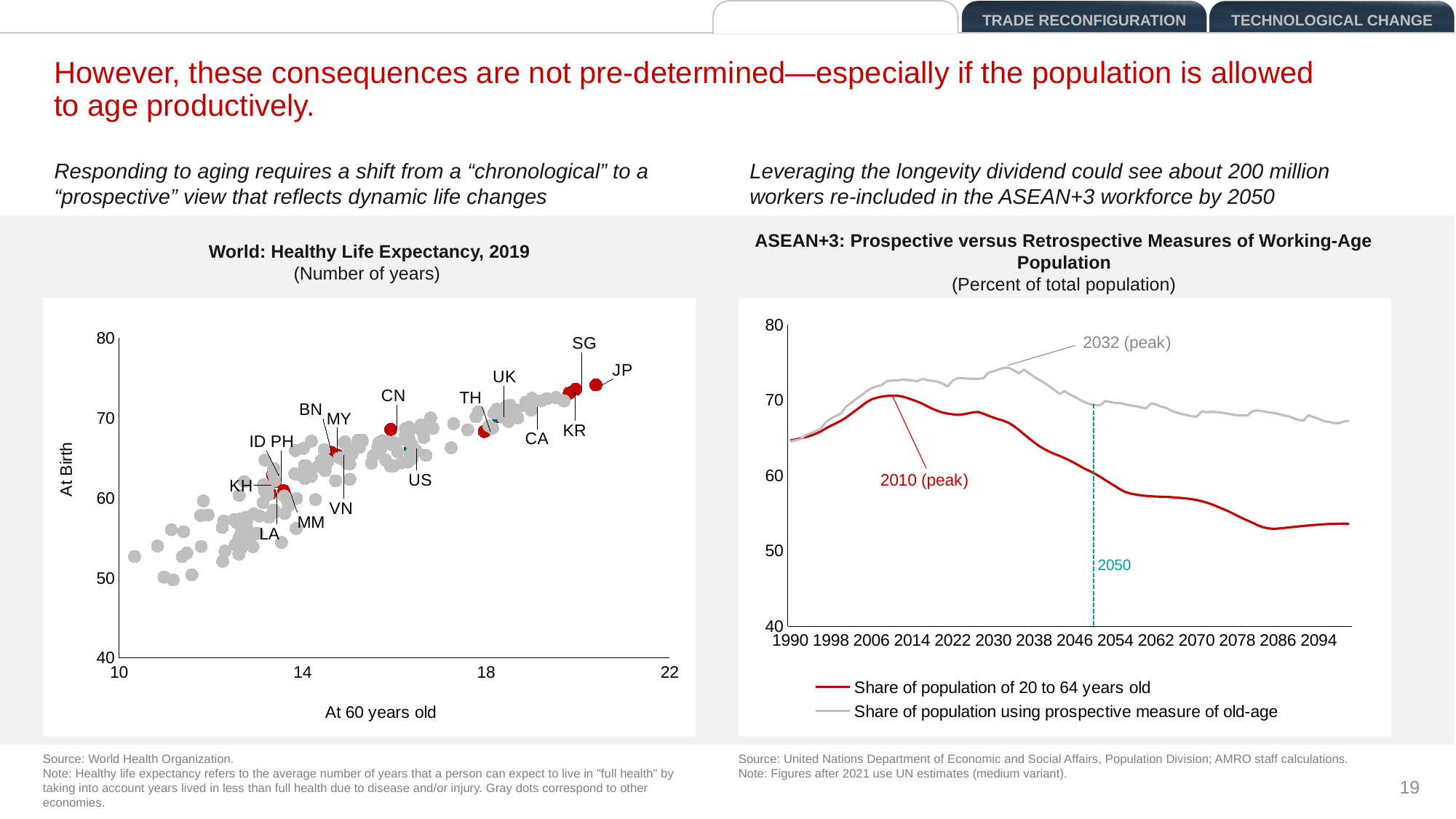
In the right chart 'ASEAN+3: Prospective versus Retrospective Measures of Working-Age Population', in which year does the share of population using the prospective measure of old-age peak? 2032 How many series does the legend of the right chart 'ASEAN+3: Prospective versus Retrospective Measures of Working-Age Population' list? 2 In the right chart 'ASEAN+3: Prospective versus Retrospective Measures of Working-Age Population', is the share of population of 20 to 64 years old in 2094 greater or less than 60? less In the left chart 'World: Healthy Life Expectancy, 2019', what is the label of the x axis? At 60 years old In the right chart 'ASEAN+3: Prospective versus Retrospective Measures of Working-Age Population', in which year does the share of population of 20 to 64 years old peak? 2010 In the left chart 'World: Healthy Life Expectancy, 2019', which has a higher healthy life expectancy at birth, SG or KH? SG In the left chart 'World: Healthy Life Expectancy, 2019', is the healthy life expectancy at 60 years old for KH greater or less than 14? less In the left chart 'World: Healthy Life Expectancy, 2019', which labeled economy has the highest healthy life expectancy at birth? JP In the left chart 'World: Healthy Life Expectancy, 2019', is the healthy life expectancy at birth for JP greater or less than 70? greater What kind of chart is the right chart, 'ASEAN+3: Prospective versus Retrospective Measures of Working-Age Population'? line chart In the right chart 'ASEAN+3: Prospective versus Retrospective Measures of Working-Age Population', does the share of population of 20 to 64 years old rise or fall between 2010 and 2094? fall What kind of chart is the left chart, 'World: Healthy Life Expectancy, 2019'? scatter chart